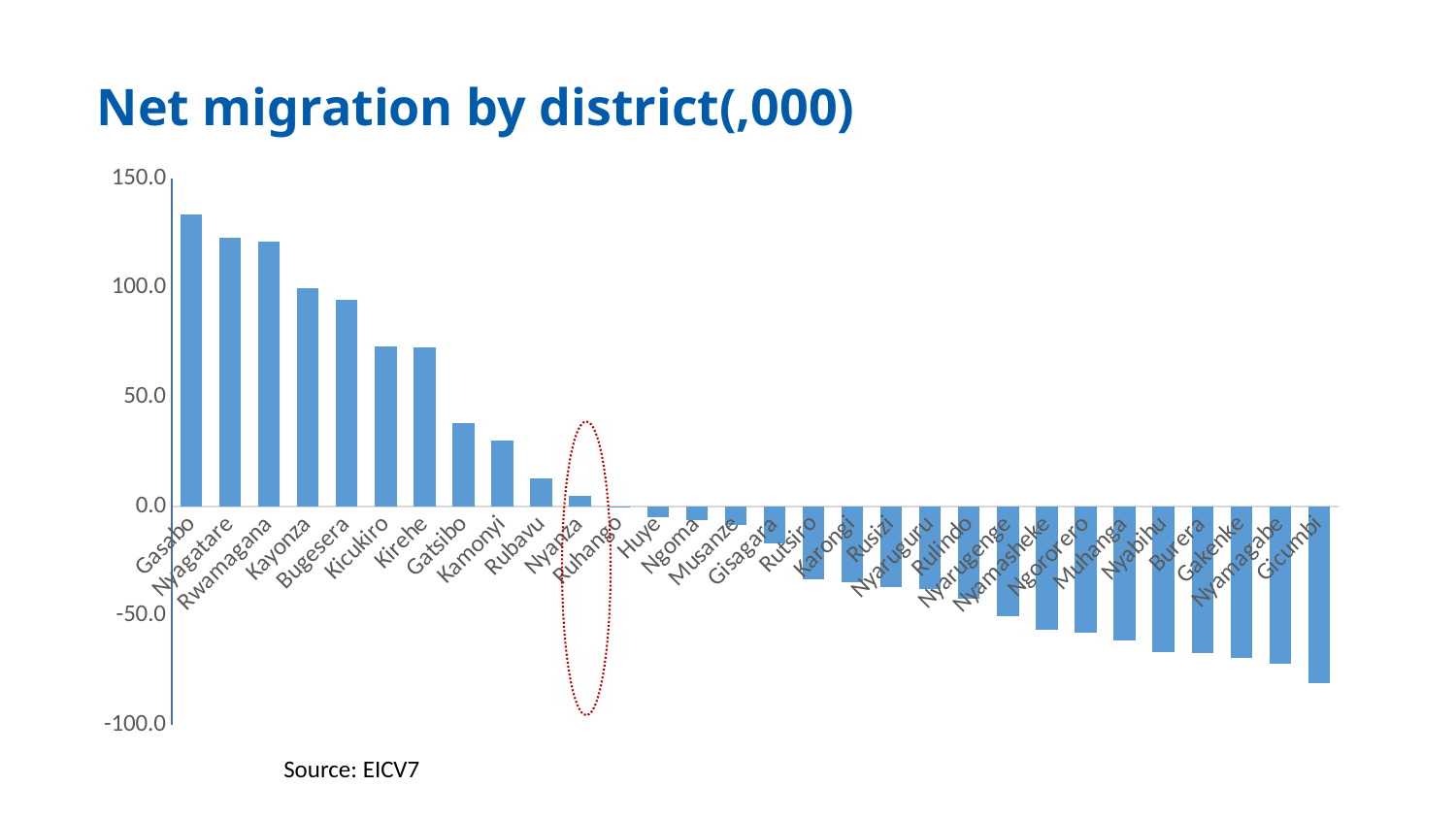
What is the title of the chart? Net migration by district(,000) How many districts are shown on the x axis? 30 Which district's bar is circled with a red dotted ellipse? Nyanza Is the value for Gasabo greater or less than 100.0? greater Which district has the highest net migration? Gasabo Which is larger, the value for Gasabo or the value for Nyagatare? Gasabo Is the value for Gatsibo greater or less than 50.0? less Which district has the lowest net migration? Gicumbi Do the values rise or fall moving from left to right along the x axis? fall Is the value for Gicumbi greater or less than -50.0? less What kind of chart is shown on the slide? Bar chart